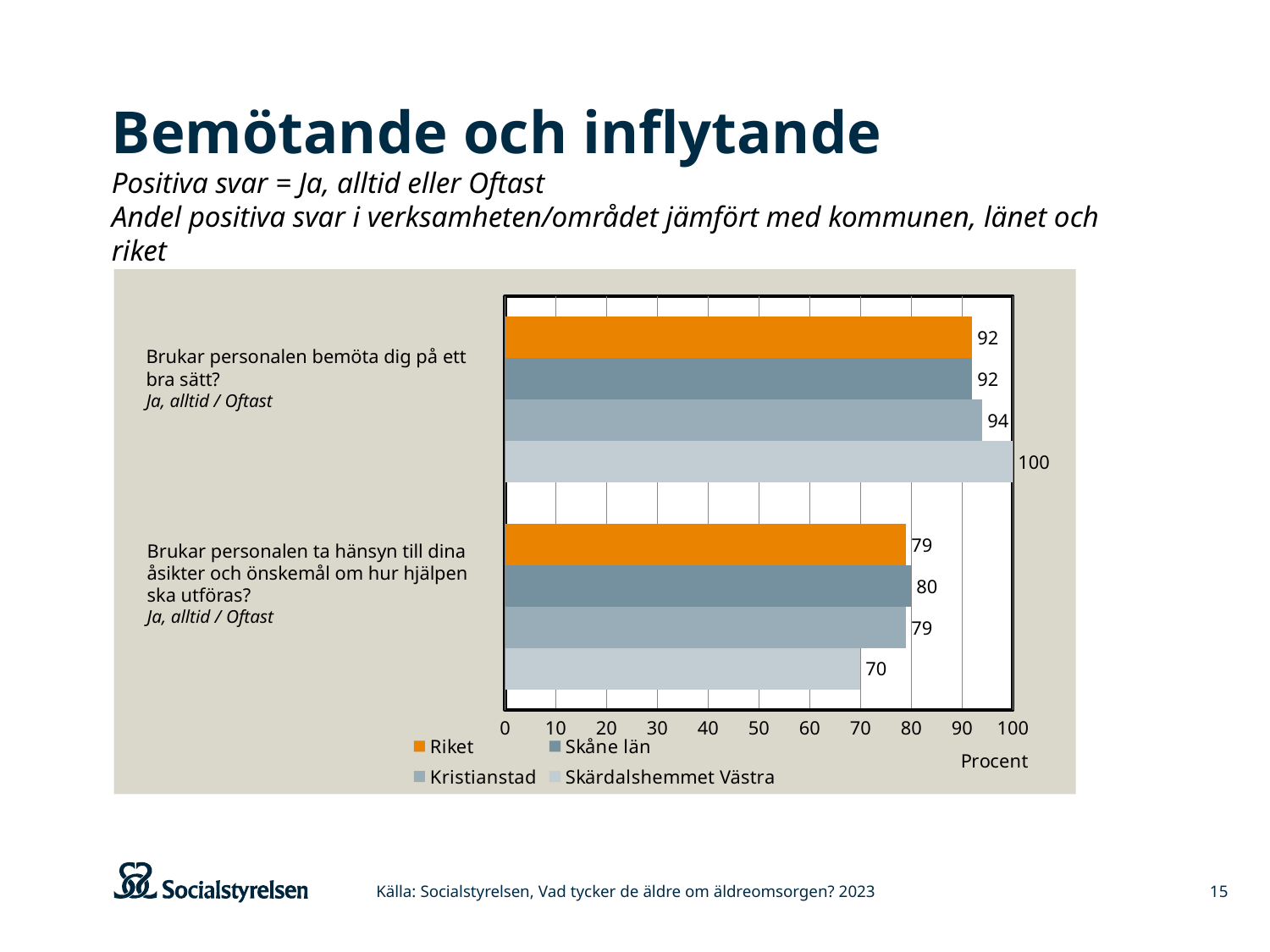
What is the value for Skåne län for the question "Brukar personalen ta hänsyn till dina åsikter och önskemål om hur hjälpen ska utföras?"? 80 What is the difference between the Skärdalshemmet Västra value and the Riket value for the question "Brukar personalen bemöta dig på ett bra sätt?"? 8 What is the value for Kristianstad for the question "Brukar personalen bemöta dig på ett bra sätt?"? 94 What is the difference between the Skåne län value and the Skärdalshemmet Västra value for the question "Brukar personalen ta hänsyn till dina åsikter och önskemål om hur hjälpen ska utföras?"? 10 What is the value for Skärdalshemmet Västra for the question "Brukar personalen bemöta dig på ett bra sätt?"? 100 What kind of chart is shown on the slide? bar chart What is the value for Riket for the question "Brukar personalen ta hänsyn till dina åsikter och önskemål om hur hjälpen ska utföras?"? 79 Which series has the lowest value for the question "Brukar personalen ta hänsyn till dina åsikter och önskemål om hur hjälpen ska utföras?"? Skärdalshemmet Västra What label is shown on the horizontal axis of the chart? Procent Which series has the highest value for the question "Brukar personalen bemöta dig på ett bra sätt?"? Skärdalshemmet Västra How many series does the legend list? 4 For the question "Brukar personalen ta hänsyn till dina åsikter och önskemål om hur hjälpen ska utföras?", which is larger: the value for Kristianstad or the value for Skärdalshemmet Västra? Kristianstad